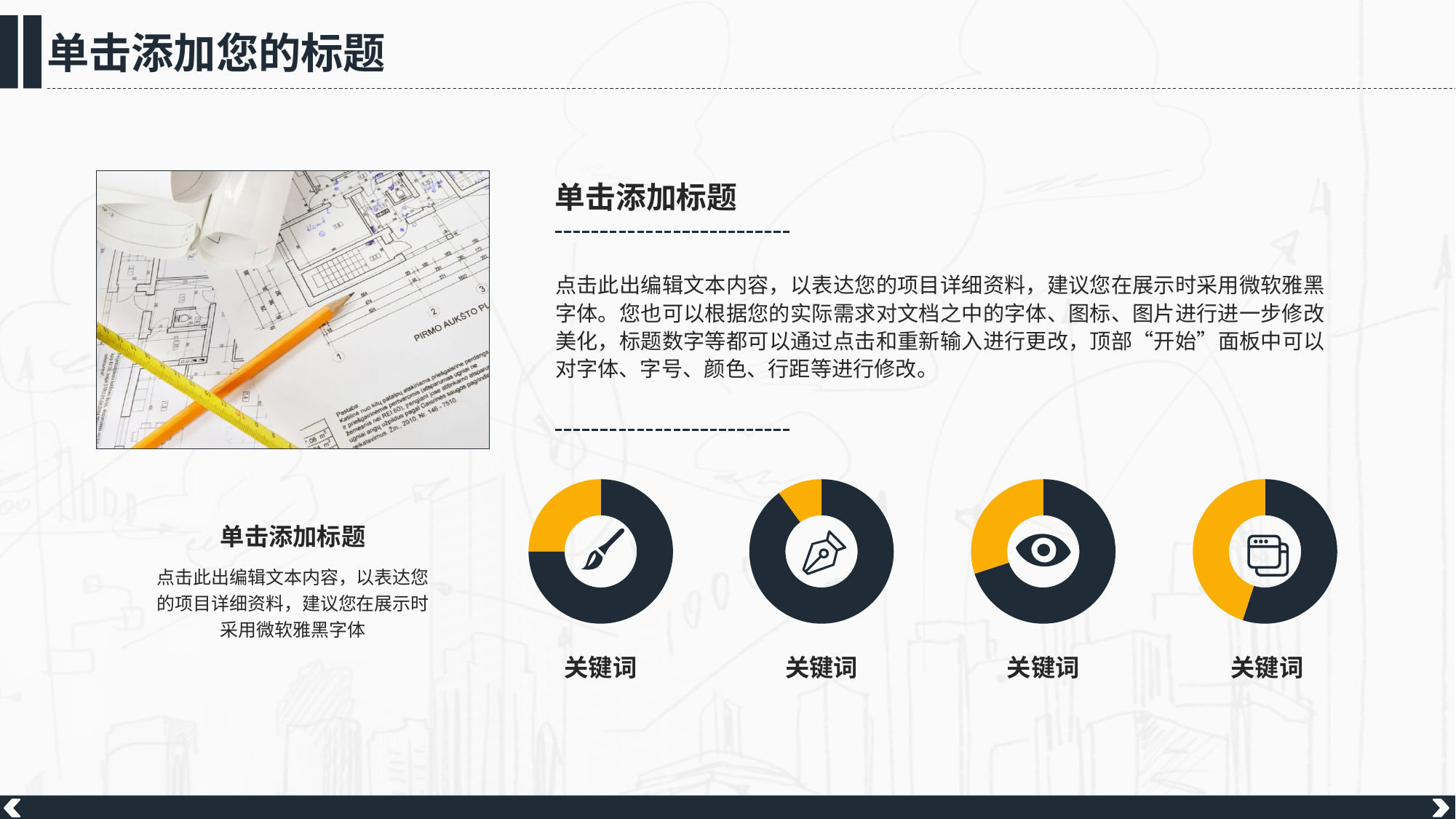
In the second donut chart, which segment is larger, the yellow one or the dark one? The dark one How many donut charts are shown on the slide? 4 Is the yellow segment of the third donut chart larger or smaller than the yellow segment of the second donut chart? Larger Which of the four donut charts has the largest yellow segment? The fourth (rightmost) chart Which of the four donut charts has the smallest yellow segment? The second chart (pen nib icon) How many segments does each donut chart have? 2 What kind of chart are the four charts in the lower right of the slide? Donut (pie) charts What two colours are used for the segments of the donut charts? Yellow and dark navy What label appears beneath each of the four donut charts? 关键词 In the first (leftmost) donut chart, which segment is larger, the yellow one or the dark one? The dark one